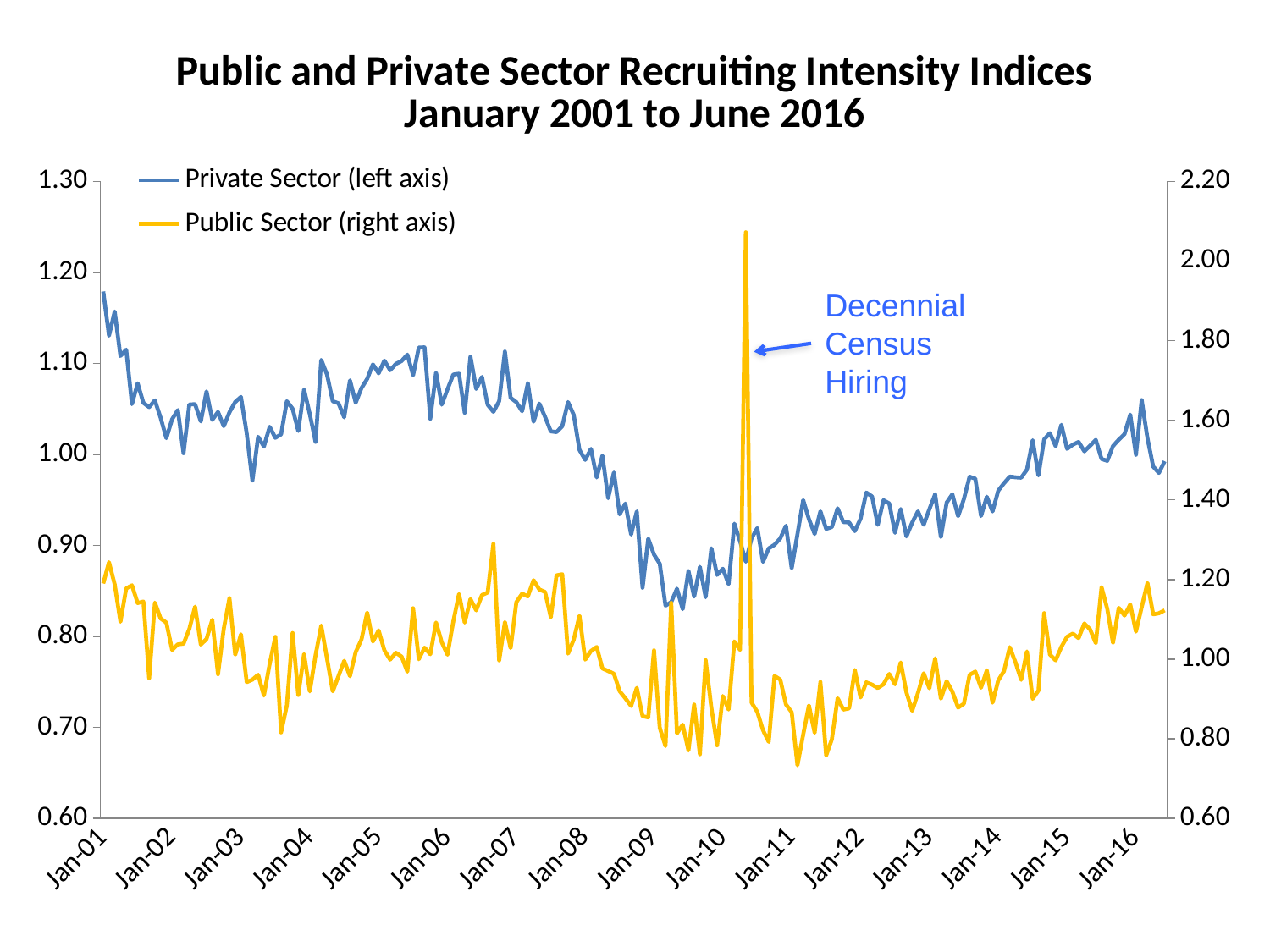
How many series does the legend list? 2 How many year labels are shown on the x axis? 16 Does the Private Sector series rise or fall between Jan-08 and Jan-09? Fall Is the Public Sector value at its 2010 spike greater or less than 2.00 on the right axis? greater Is the Public Sector value at Jan-11 greater or less than 1.00 on the right axis? less Is the Private Sector value at Jan-12 greater or less than 1.00 on the left axis? less What is the title of the chart? Public and Private Sector Recruiting Intensity Indices January 2001 to June 2016 Does the Private Sector series generally rise or fall between Jan-10 and Jan-15? Rise Which series is plotted against the right axis? Public Sector What kind of chart is shown on the slide? Line chart Which series shows the sharp spike in 2010 labelled "Decennial Census Hiring"? Public Sector